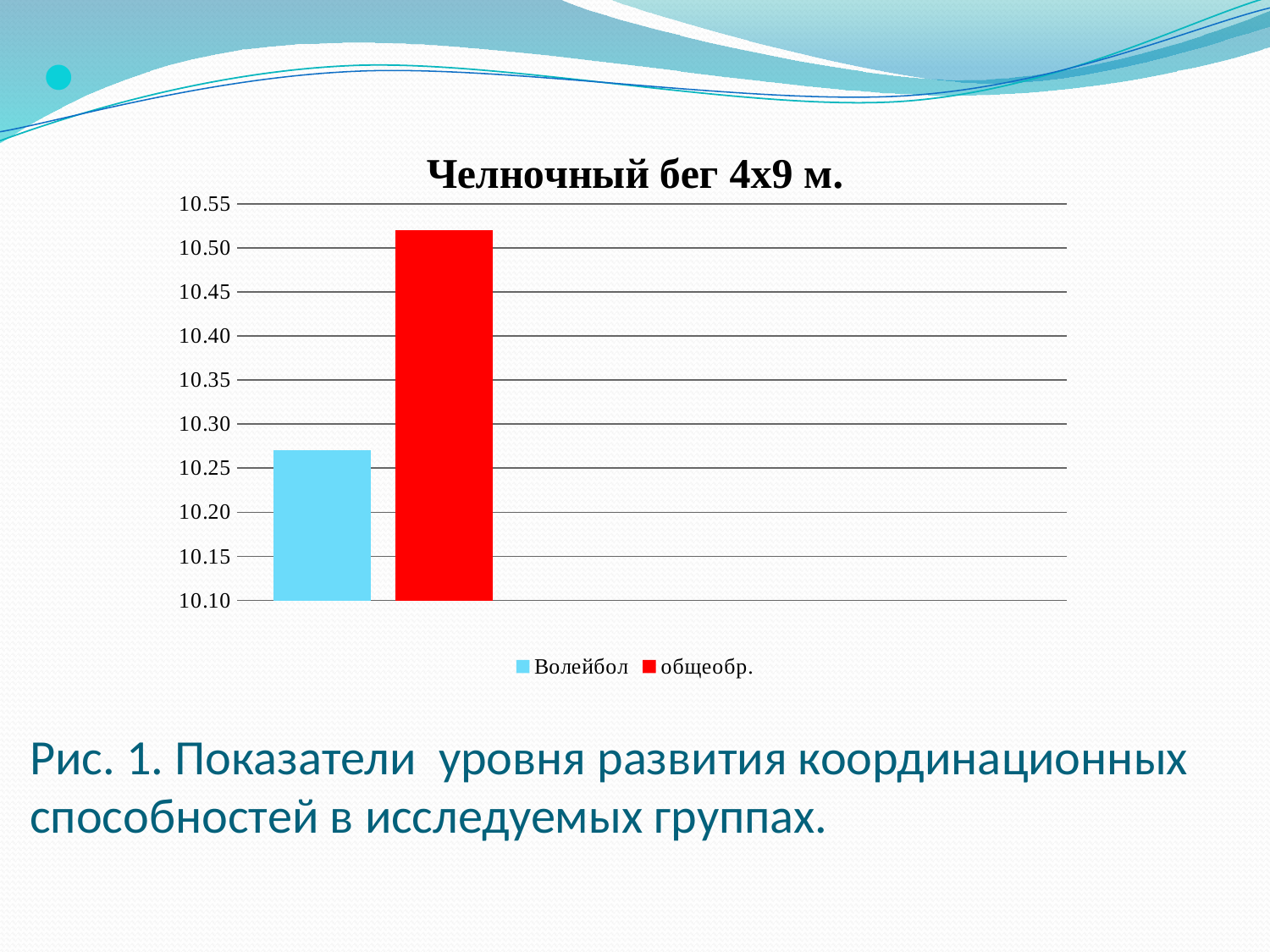
Is the value for Волейбол greater or less than 10.30? less How many bars are plotted in the chart? 2 What is the title of the chart? Челночный бег 4х9 м. Which is larger, the value for Волейбол or the value for общеобр.? общеобр. Which group has the highest bar in the chart? общеобр. What colour is the bar for Волейбол? light blue Is the value for общеобр. greater or less than 10.50? greater Is the value for общеобр. greater or less than 10.55? less Which group has the lowest bar in the chart? Волейбол What kind of chart is shown on the slide? bar chart How many series does the legend list? 2